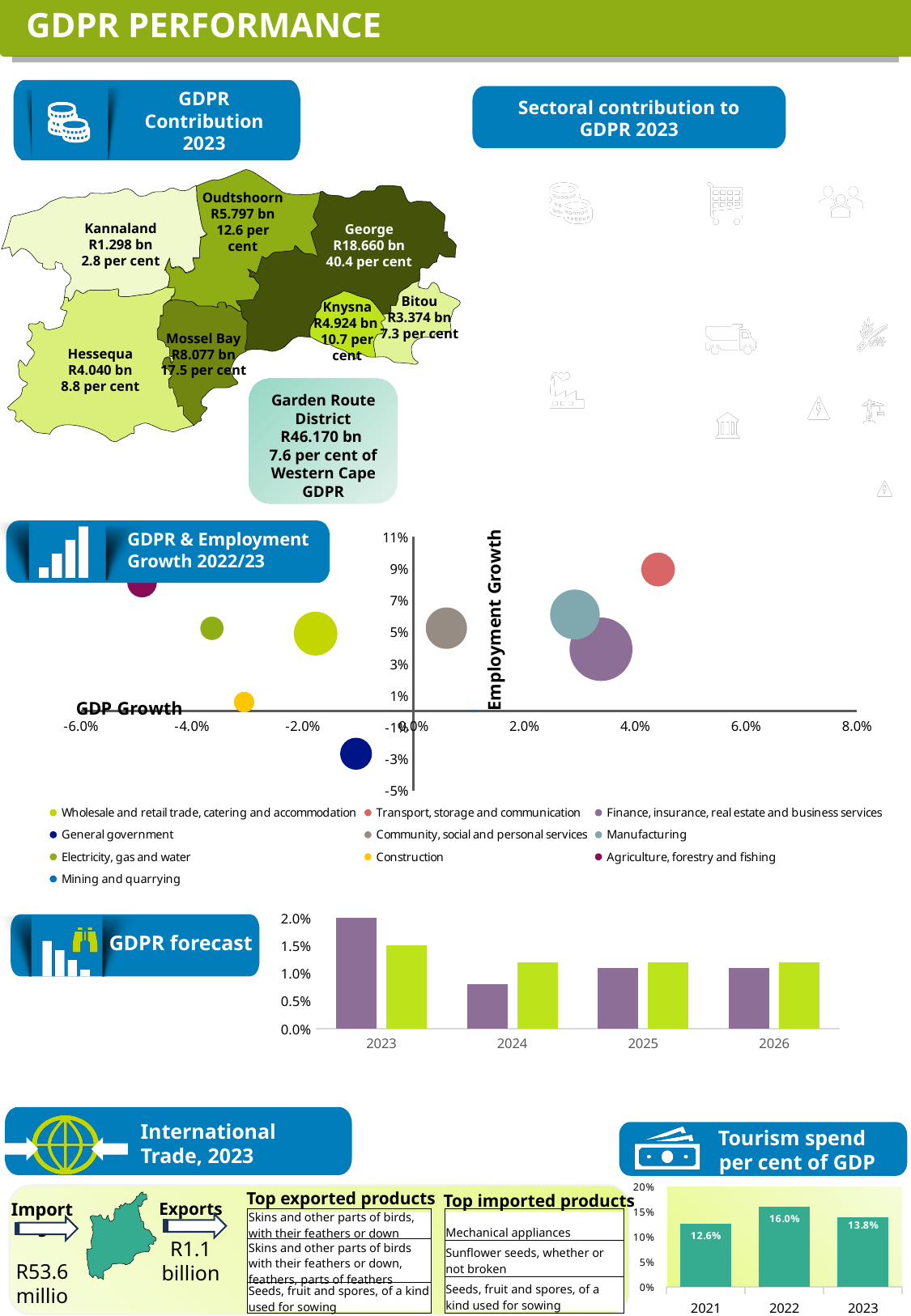
On the GDPR forecast chart, is the purple bar for 2024 greater or less than 1.0%? less On the GDPR & Employment Growth 2022/23 chart, is the employment growth for Transport, storage and communication greater or less than 7%? greater On the Tourism spend per cent of GDP chart, which year has the highest value? 2022 On the Tourism spend per cent of GDP chart, which year has the lowest value? 2021 On the Tourism spend per cent of GDP chart, which is larger, the value for 2023 or the value for 2021? 2023 How many years are shown on the Tourism spend per cent of GDP chart? 3 On the Tourism spend per cent of GDP chart, what is the value for 2022? 16.0% How many series does the legend of the GDPR & Employment Growth 2022/23 chart list? 10 On the GDPR forecast chart, is the purple bar for 2023 greater or less than 1.5%? greater How many years are shown on the x axis of the GDPR forecast chart? 4 On the Tourism spend per cent of GDP chart, what is the difference between the 2022 and 2021 values? 3.4% What kind of chart is the GDPR forecast chart? Bar chart